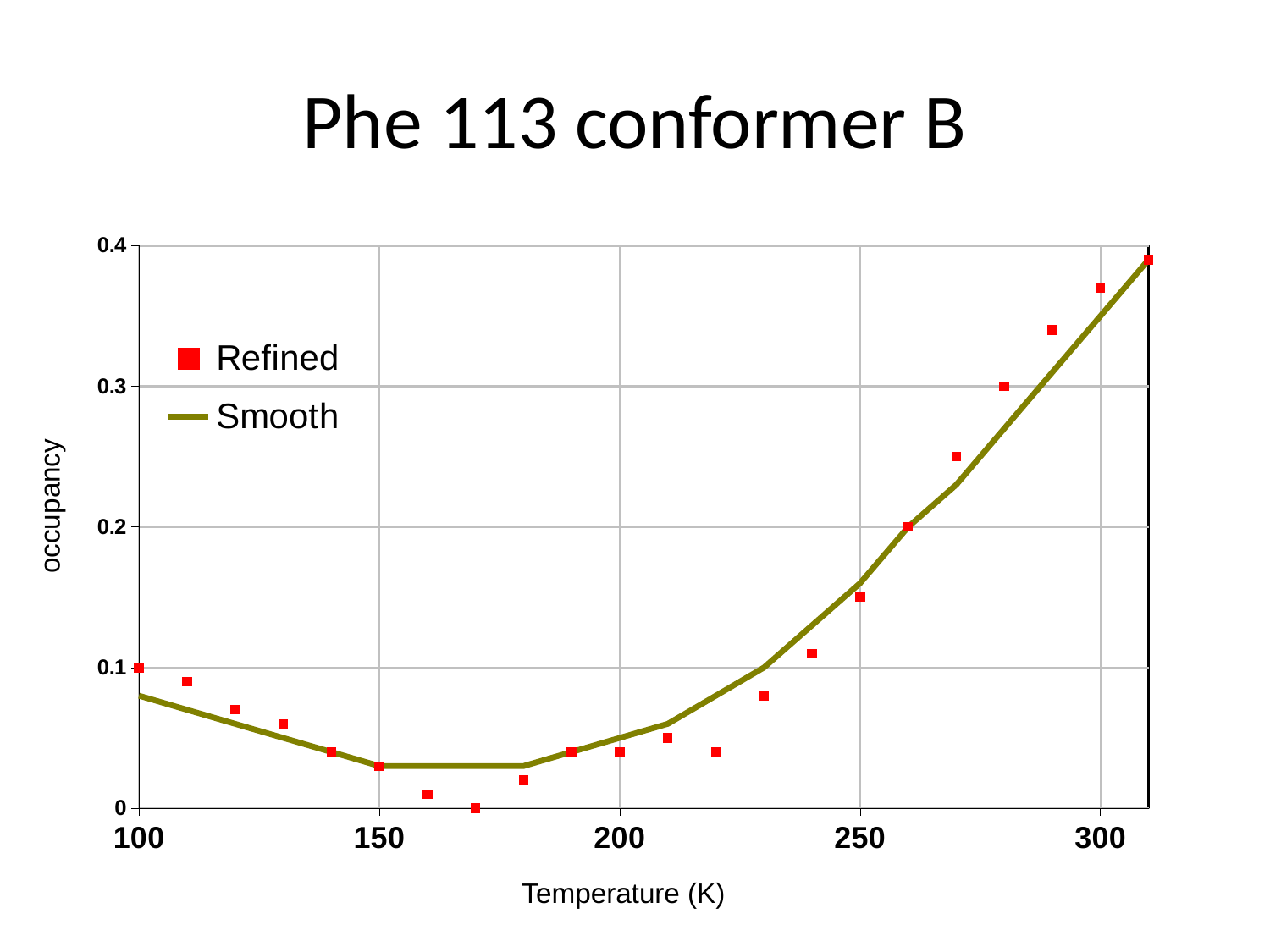
What is the title of the chart? Phe 113 conformer B Which is larger, the Refined occupancy at 110 K or at 290 K? 290 K Does the Smooth line rise or fall between 200 K and 310 K? rise At which temperature is the Refined occupancy lowest? 170 K At which temperature is the Refined occupancy highest? 310 K How many series does the legend list? 2 What is the Refined occupancy at 280 K? 0.3 Is the Refined occupancy at 250 K greater or less than 0.2? less What is the Refined occupancy at 170 K? 0 What is the label of the x axis? Temperature (K) What is the Refined occupancy at 100 K? 0.1 What kind of chart is shown on the slide? line chart